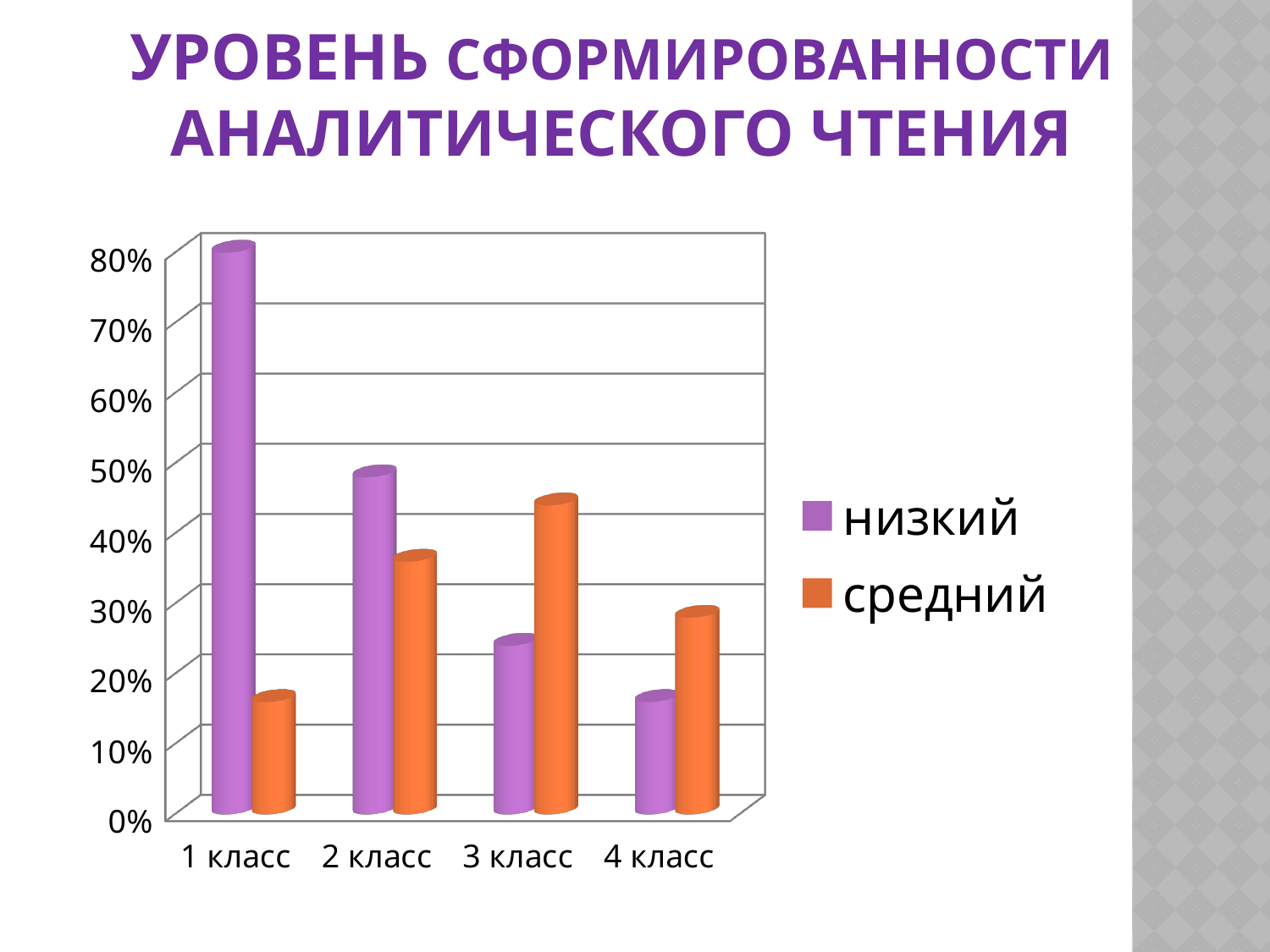
Which class has the highest value for the 'средний' series? 3 класс For 1 класс, which series has the larger value, 'низкий' or 'средний'? низкий Is the 'низкий' value for 1 класс greater or less than 70%? greater What kind of chart is shown on the slide? bar chart How many series does the legend list? 2 Which class has the highest value for the 'низкий' series? 1 класс Which class has the lowest value for the 'средний' series? 1 класс Is the 'средний' value for 1 класс greater or less than 30%? less Does the 'низкий' series rise or fall from 1 класс to 4 класс? fall Is the 'средний' value for 3 класс greater or less than 40%? greater How many categories (classes) are shown on the x axis? 4 Which class has the lowest value for the 'низкий' series? 4 класс